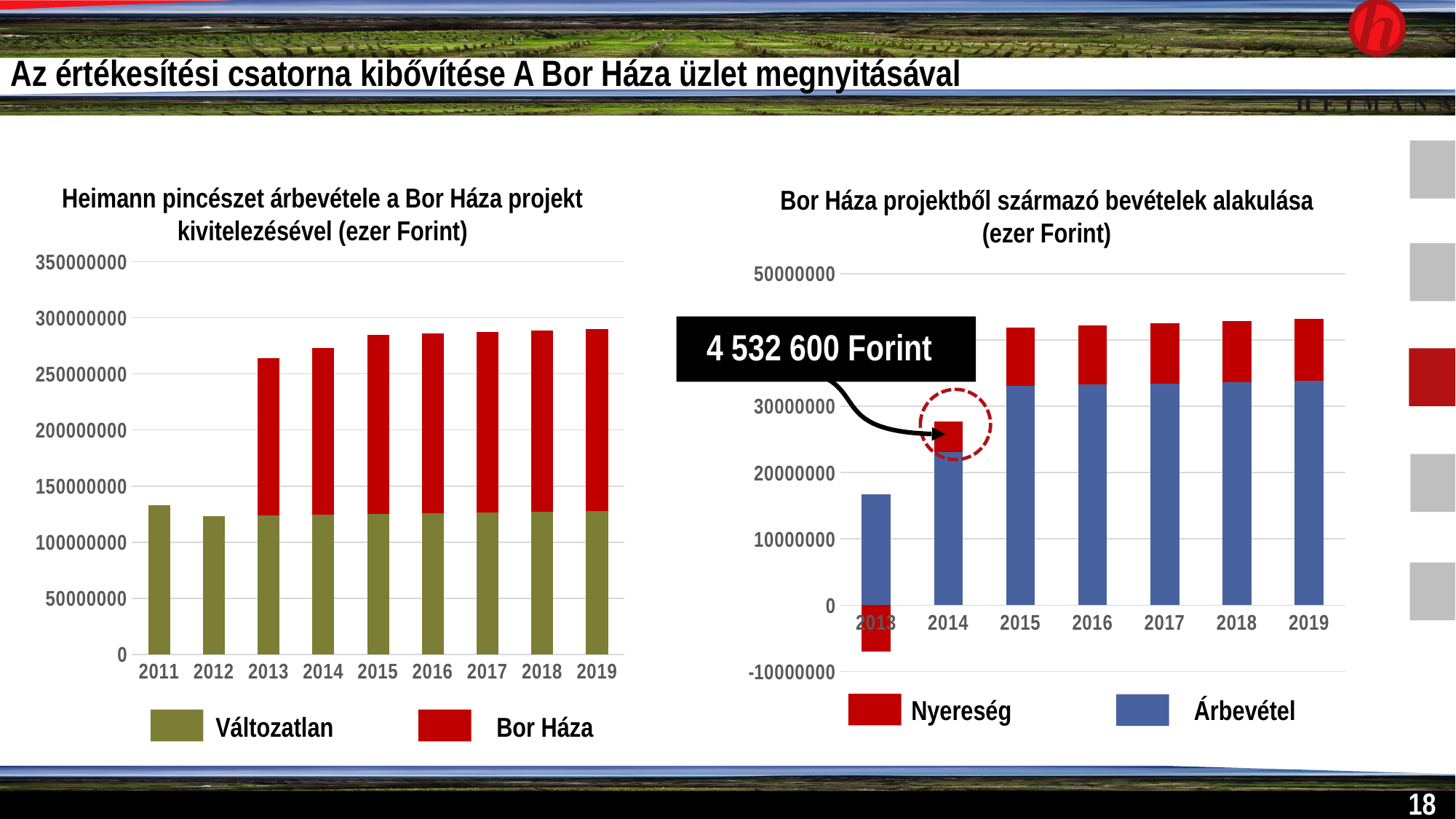
What are the two legend entries of the left chart? Változatlan and Bor Háza In the left chart, do the total bar heights rise or fall from 2013 to 2019? Rise How many years are shown on the x axis of the left chart? 9 In the right chart, is the Nyereség value for 2013 greater or less than 0? less In the right chart, what value does the callout give for the Nyereség segment of 2014? 4 532 600 Forint How many series does the legend of the left chart list? 2 In the left chart, is the total bar for 2019 greater or less than 300000000? less In the right chart, which series is shown in blue? Árbevétel How many years are shown on the x axis of the right chart, 'Bor Háza projektből származó bevételek alakulása'? 7 What kind of chart is the left chart, 'Heimann pincészet árbevétele a Bor Háza projekt kivitelezésével'? Stacked bar chart In the left chart, is the value for 2011 greater or less than 100000000? greater In the left chart, which is larger, the bar for 2011 or the bar for 2012? 2011